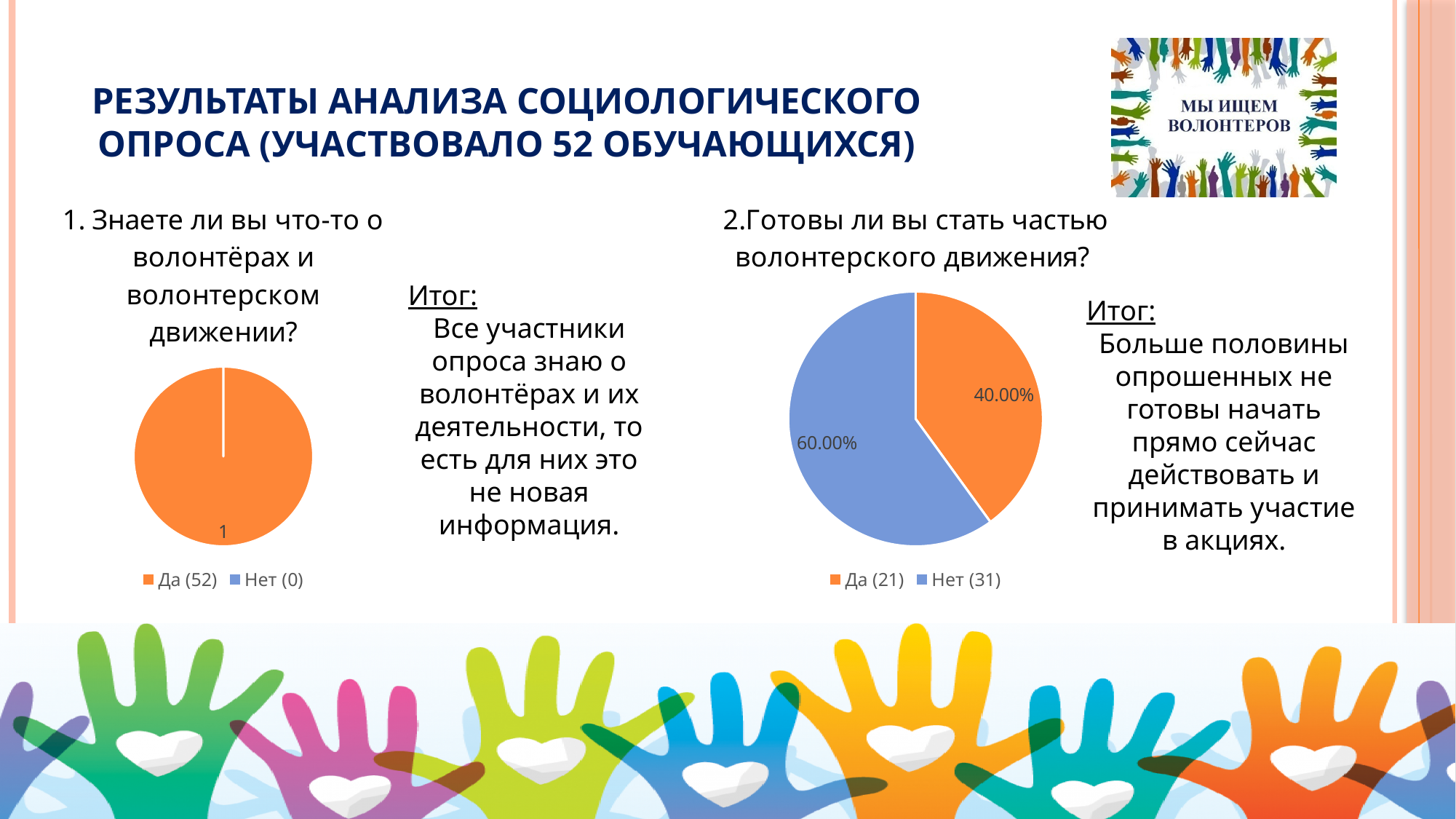
In the pie chart for question 2, what share of the pie is labelled for "Да (21)"? 40.00% In the pie chart for question 1, how many respondents answered "Нет" according to the legend? 0 What kind of chart is used for question 2 ("Готовы ли вы стать частью волонтерского движения?")? pie chart In the pie chart for question 2, which slice is the largest? Нет (31) In the pie chart for question 2, how many more respondents answered "Нет" than "Да" according to the legend? 10 In the pie chart for question 2, what share of the pie is labelled for "Нет (31)"? 60.00% In the pie chart for question 2, which slice is the smallest? Да (21) In the pie chart for question 2, what colour is the "Да (21)" slice? orange What kind of chart is used for question 1 ("Знаете ли вы что-то о волонтёрах и волонтерском движении?")? pie chart How many categories does the legend of the pie chart for question 1 list? 2 In the pie chart for question 2, which is larger: the "Да" slice or the "Нет" slice? Нет In the pie chart for question 2, what is the difference in percentage points between the "Нет" slice and the "Да" slice? 20.00%